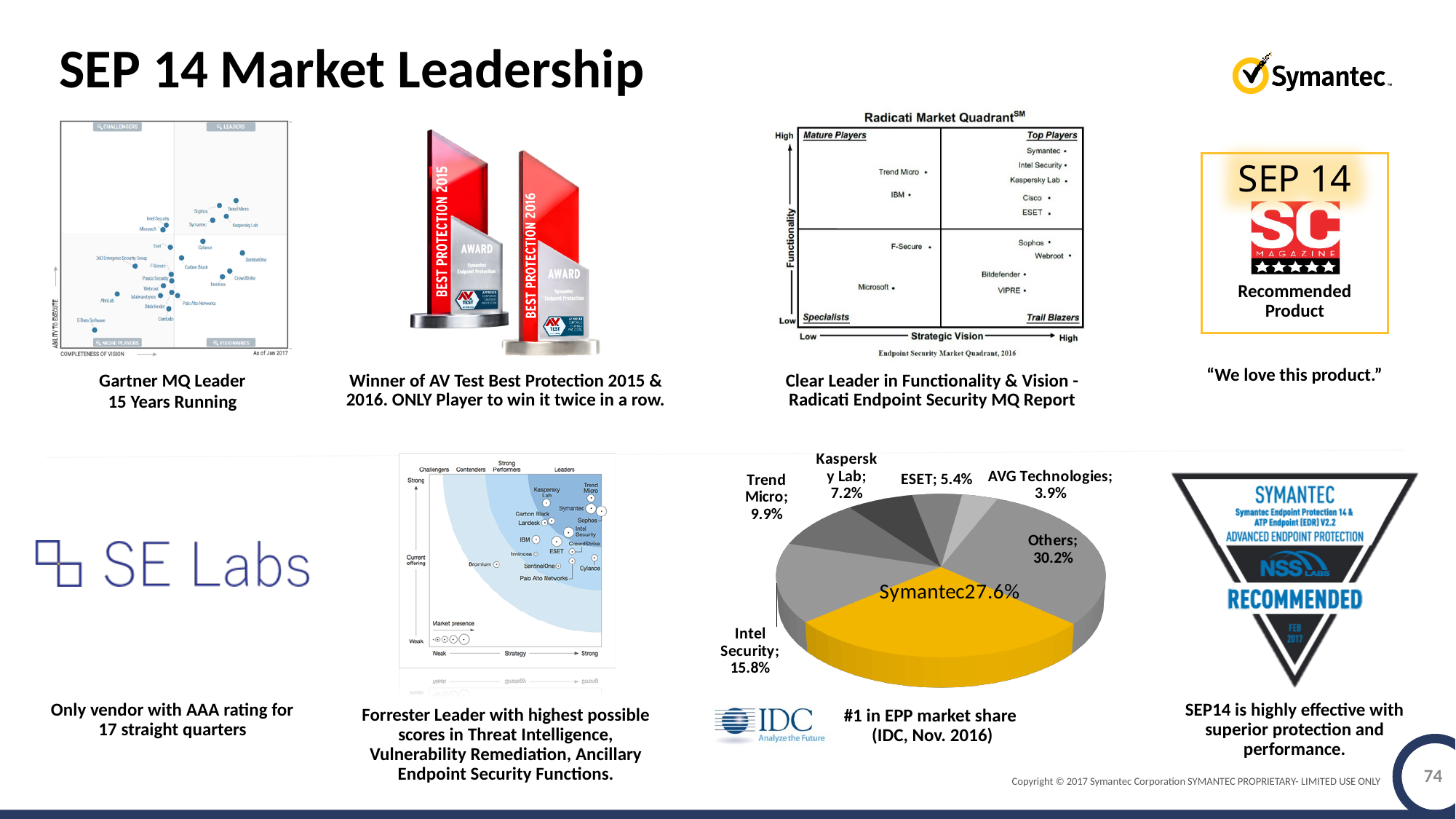
In the pie chart of EPP market share, which has the larger share, Kaspersky Lab or ESET? Kaspersky Lab In the pie chart of EPP market share, how many percentage points larger is Symantec's share than Intel Security's? 11.8 In the pie chart of EPP market share, which slice is the largest? Others In the pie chart of EPP market share, what share is shown for Others? 30.2% In the pie chart of EPP market share, how many slices are there? 7 In the pie chart of EPP market share, what share is shown for Symantec? 27.6% In the pie chart of EPP market share, which slice is the smallest? AVG Technologies What kind of chart is used to show the EPP market share (IDC, Nov. 2016)? Pie chart In the pie chart of EPP market share, what colour is the Symantec slice? Yellow In the pie chart of EPP market share, what share is shown for Trend Micro? 9.9% In the pie chart of EPP market share, what share is shown for ESET? 5.4% In the pie chart of EPP market share, what share is shown for Intel Security? 15.8%